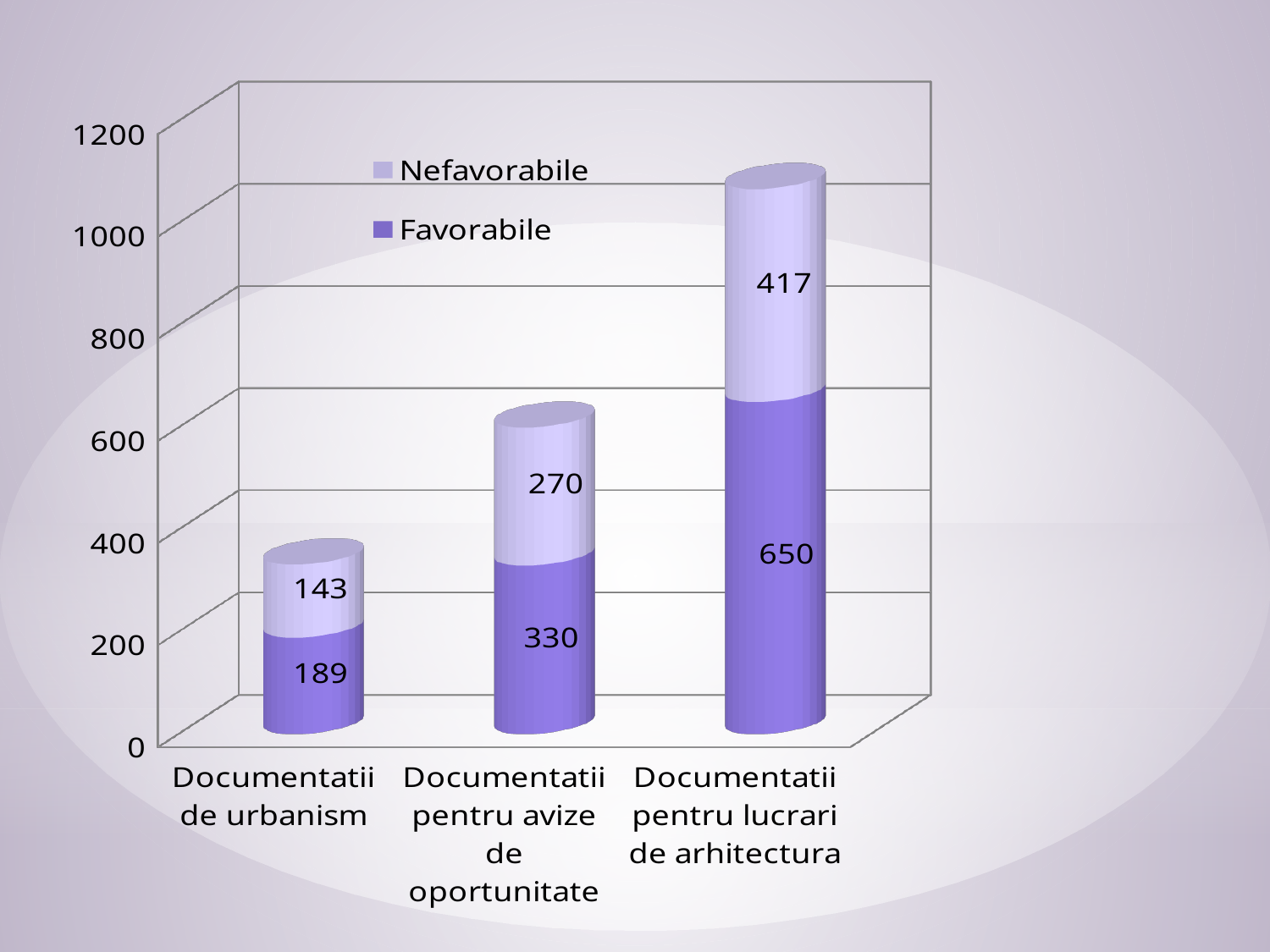
What is the total of the stacked bar for Documentatii pentru avize de oportunitate? 600 What is the Nefavorabile value for Documentatii pentru avize de oportunitate? 270 What kind of chart is shown on the slide? Stacked bar chart Which category has the highest Favorabile value? Documentatii pentru lucrari de arhitectura How many series does the legend list? 2 What is the total of the stacked bar for Documentatii de urbanism? 332 What is the difference between the Favorabile and Nefavorabile values for Documentatii pentru lucrari de arhitectura? 233 What is the Favorabile value for Documentatii de urbanism? 189 What is the Nefavorabile value for Documentatii de urbanism? 143 Which is larger for Documentatii pentru avize de oportunitate: Favorabile or Nefavorabile? Favorabile What is the Favorabile value for Documentatii pentru lucrari de arhitectura? 650 Which category has the lowest Nefavorabile value? Documentatii de urbanism